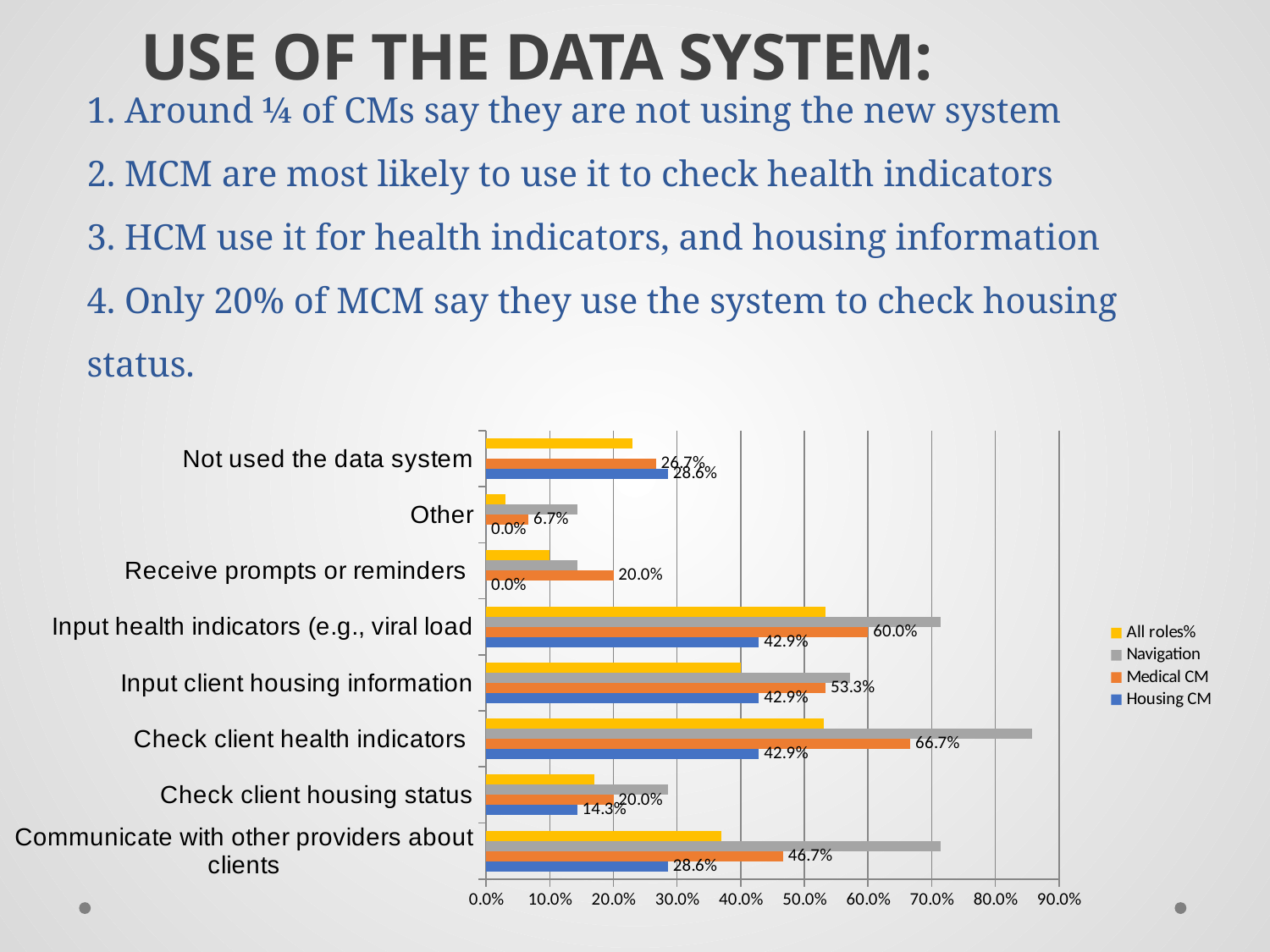
For "Check client health indicators", how much higher is the Medical CM value than the Housing CM value? 23.8 percentage points What is the Medical CM value for "Check client health indicators"? 66.7% What is the Medical CM value for "Input client housing information"? 53.3% Is the Navigation value for "Check client health indicators" greater or less than 80.0%? greater How many categories are shown on the chart? 8 Which category has the lowest Medical CM value? Other What is the Housing CM value for "Check client housing status"? 14.3% For "Input health indicators (e.g., viral load)", which is larger: the Medical CM value or the Housing CM value? Medical CM How many series does the legend list? 4 Which category has the highest Medical CM value? Check client health indicators Is the All roles% value for "Communicate with other providers about clients" greater or less than 30.0%? greater What is the Housing CM value for "Not used the data system"? 28.6%